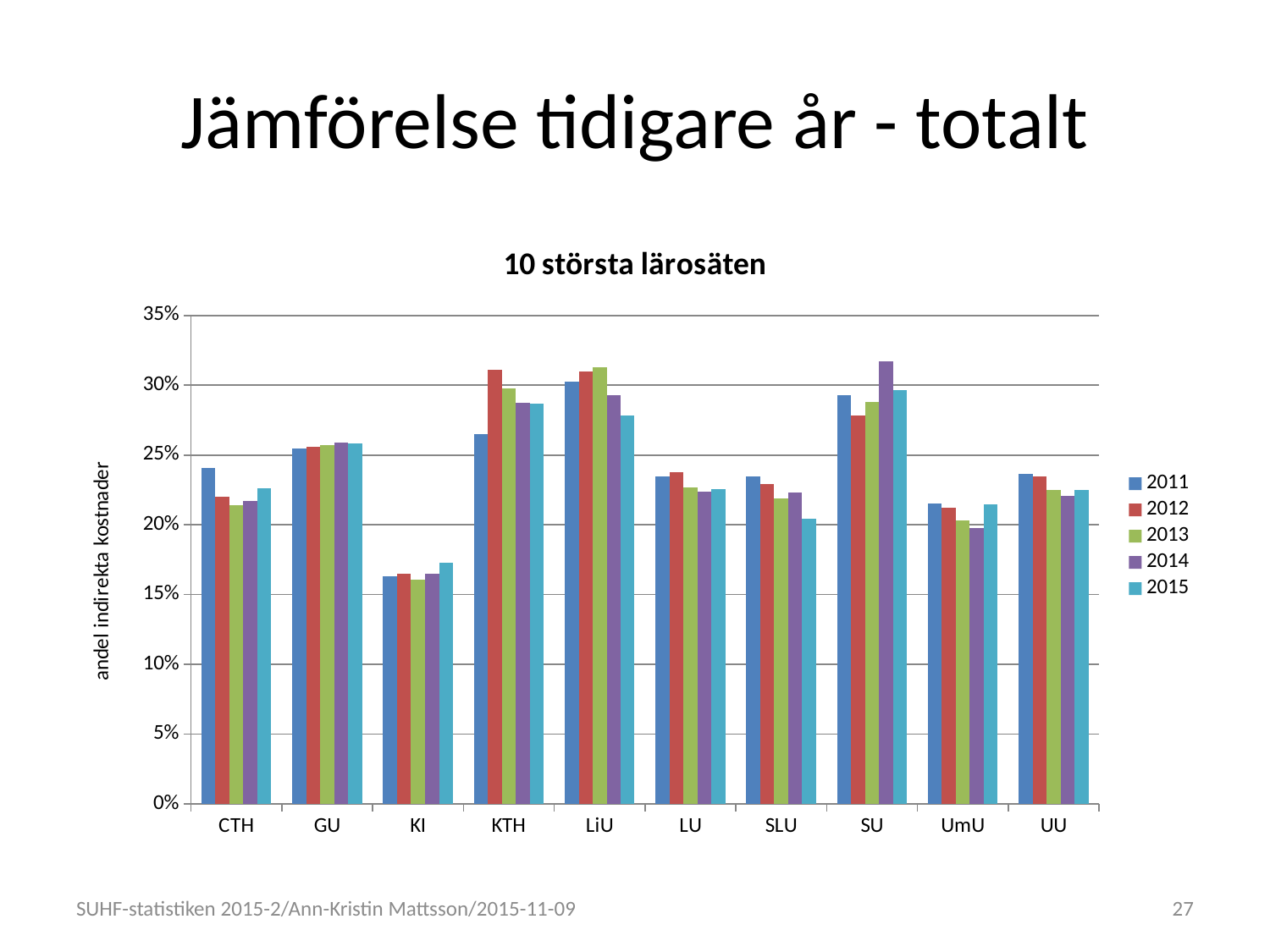
Is the value for KTH in 2012 greater or less than 30%? greater Which is larger for 2015: the value for LiU or the value for SU? SU How many series does the legend list? 5 Is the value for KI in 2011 greater or less than 20%? less What kind of chart is shown on the slide? bar chart How many institutions (categories) are shown on the x axis? 10 What is the title of the chart? 10 största lärosäten Is the value for SLU in 2015 greater or less than 25%? less For CTH, which is larger: the 2011 value or the 2013 value? 2011 Which institution has the highest value for 2014? SU Which institution has the lowest value for 2015? KI Which institution has the highest value for 2011? LiU